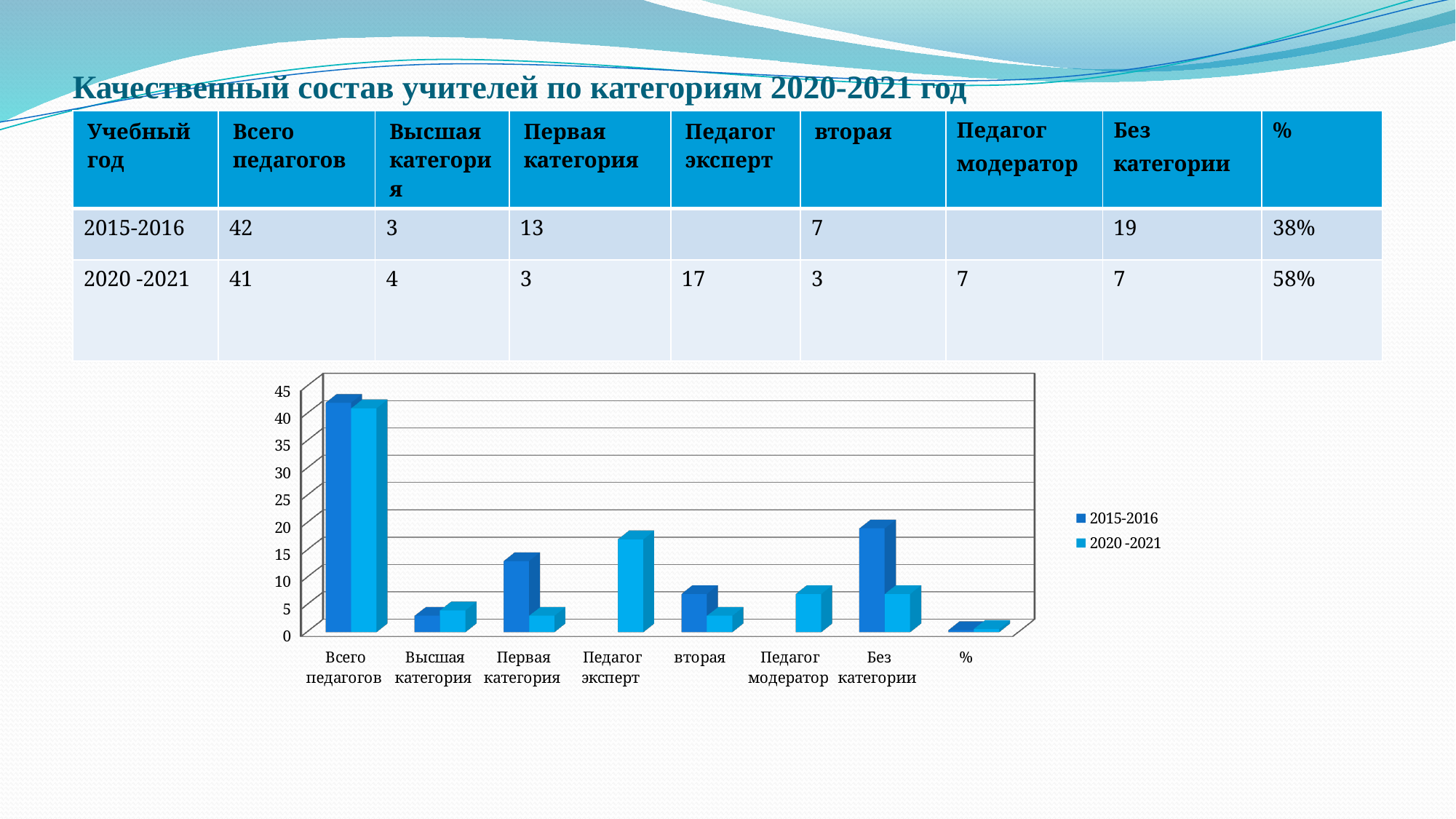
For Без категории, which series has the larger value, 2015-2016 or 2020 -2021? 2015-2016 Is the value for Первая категория in the 2015-2016 series greater or less than 10? greater For Первая категория, which series has the larger value, 2015-2016 or 2020 -2021? 2015-2016 What is the difference between the 2015-2016 and 2020 -2021 values for Без категории? 12 How many series does the chart legend list? 2 What are the two entries listed in the chart legend? 2015-2016 and 2020 -2021 Is the value for Педагог модератор in the 2020 -2021 series greater or less than 10? less What is the value for Педагог эксперт in the 2020 -2021 series? 17 Which category has the highest bar in the 2020 -2021 series? Всего педагогов How many categories are shown along the x axis of the chart? 8 What is the value for Всего педагогов in the 2015-2016 series? 42 What kind of chart is shown on the slide? bar chart